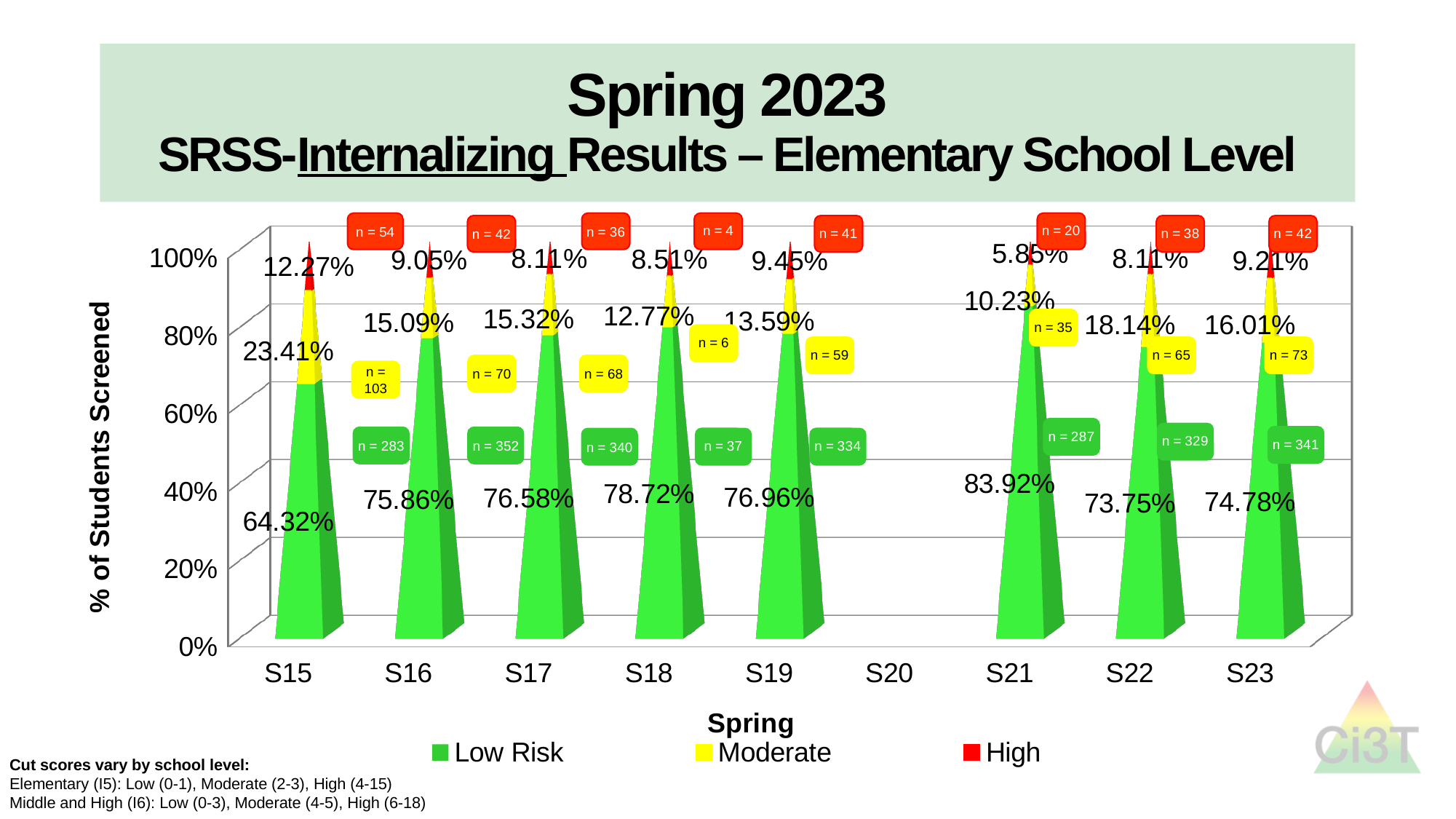
What percentage of students screened were High risk in S19? 9.45% Which is larger, the Moderate percentage for S22 or for S23? S22 Which spring has the highest Low Risk percentage? S21 What percentage of students screened were Moderate risk in S15? 23.41% What kind of chart is shown on the slide? Stacked bar chart What is the label on the y axis? % of Students Screened Which spring has the lowest Low Risk percentage? S15 How many spring labels are shown on the x axis? 9 Which spring has the highest High risk percentage? S15 What is the difference between the Low Risk percentages for S18 and S15? 14.40% How many series does the legend list? 3 What percentage of students screened were Low Risk in S21? 83.92%